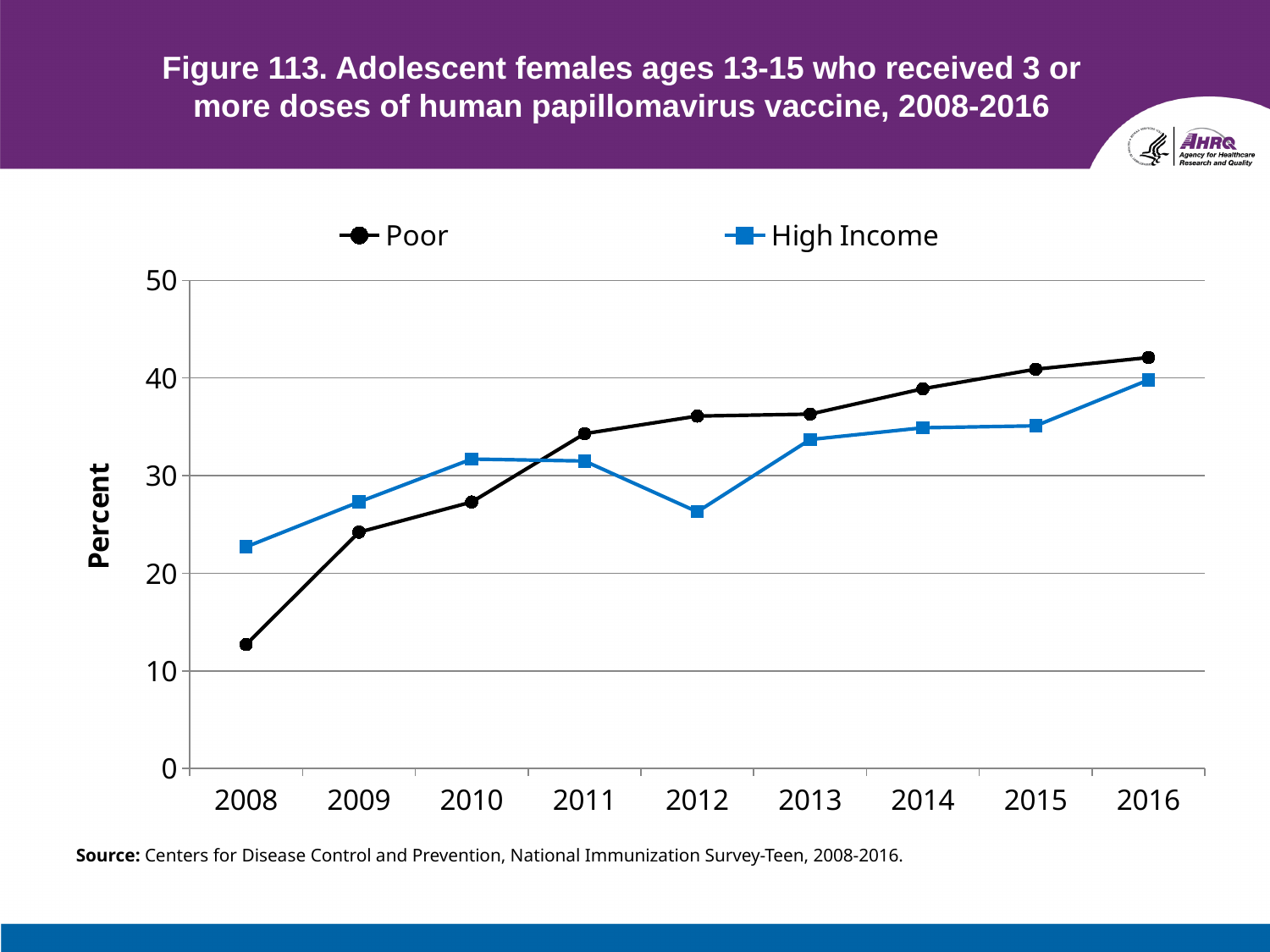
In which year is the Poor series at its lowest? 2008 How many years are plotted along the x axis? 9 In which year is the High Income series at its highest? 2016 In which year is the Poor series at its highest? 2016 Is the value for Poor in 2008 greater or less than 20? less In 2008, which series has the larger value, Poor or High Income? High Income What kind of chart is shown on the slide? line chart In 2012, which series has the larger value, Poor or High Income? Poor Is the value for High Income in 2012 greater or less than 30? less How many series does the legend list? 2 Does the Poor series generally rise or fall from 2008 to 2016? rise In which year is the High Income series at its lowest? 2008